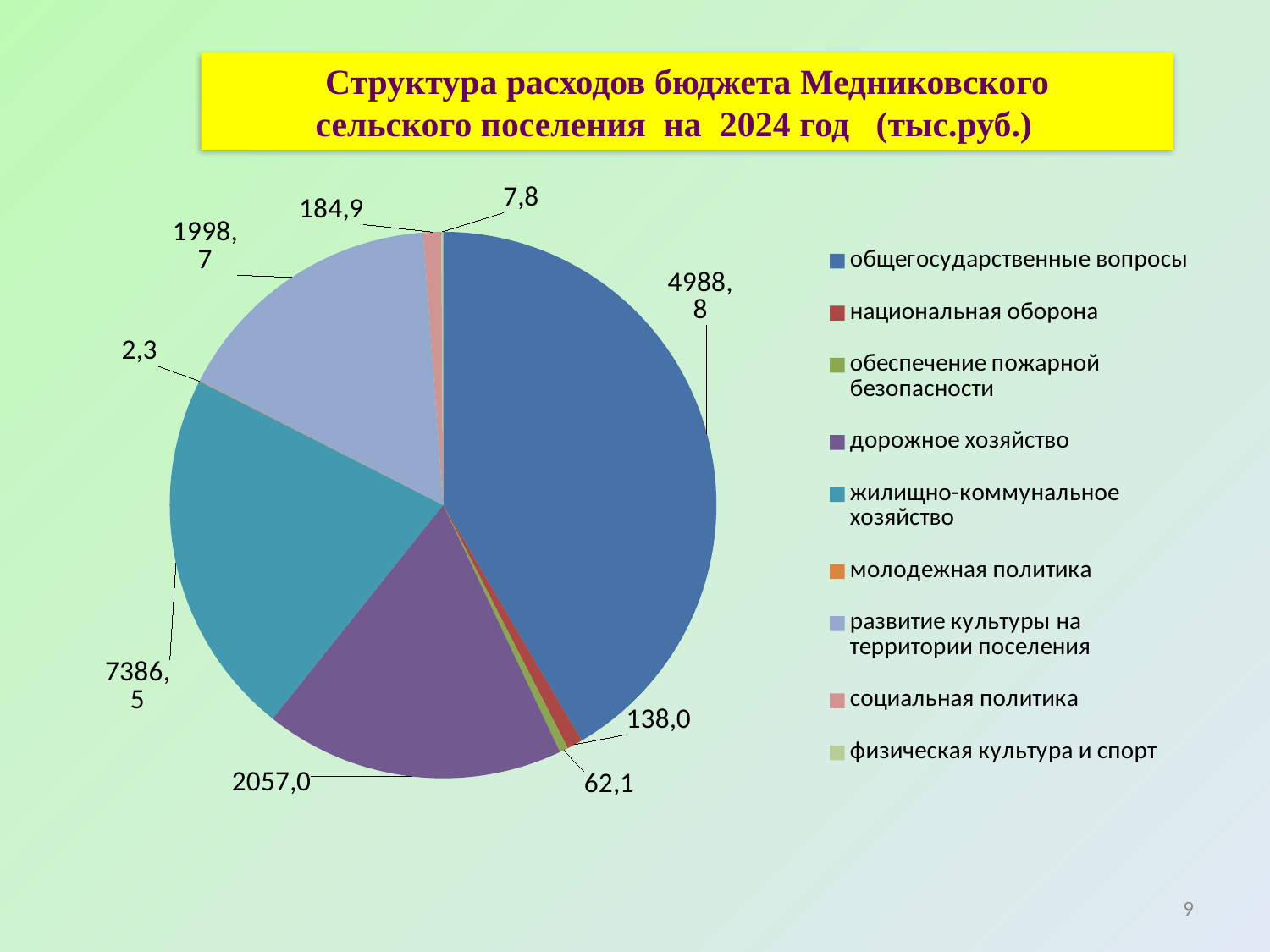
What is the difference between the values for жилищно-коммунальное хозяйство and общегосударственные вопросы? 2397,7 What is the value for развитие культуры на территории поселения? 1998,7 What is the value for дорожное хозяйство? 2057,0 Which category has the smallest value? молодежная политика What kind of chart is shown on the slide? pie chart Which category has the largest slice of the pie? общегосударственные вопросы Which is larger: the value for национальная оборона or the value for обеспечение пожарной безопасности? национальная оборона How many categories does the legend list? 9 What is the value for социальная политика? 184,9 What is the value for жилищно-коммунальное хозяйство? 7386,5 What is the value for молодежная политика? 2,3 What is the value for общегосударственные вопросы? 4988,8